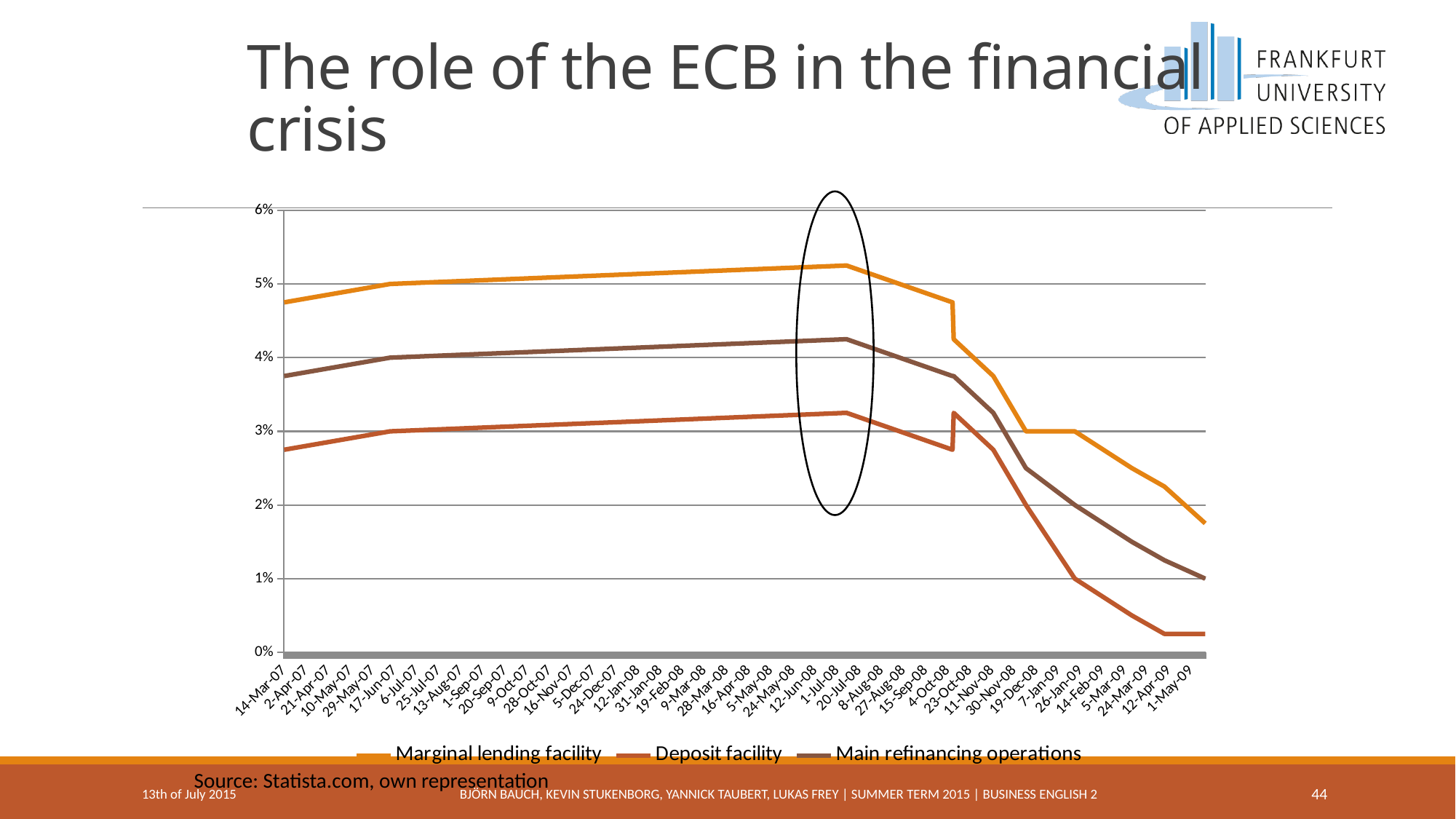
What is the highest value shown on the vertical axis? 6% What is the value of the Marginal lending facility at 17-Jun-07? 5% Is the value of the Marginal lending facility at 14-Mar-07 greater or less than 5%? less Which series has the lowest values throughout the chart? Deposit facility What is the value of Main refinancing operations at 1-May-09? 1% Which series has the highest values throughout the chart? Marginal lending facility At 1-May-09, which is larger: the Marginal lending facility or Main refinancing operations? Marginal lending facility Is the value of the Deposit facility at 1-May-09 greater or less than 1%? less What kind of chart is shown on the slide? line chart How many series does the legend list? 3 Do the values of the Deposit facility rise or fall between 20-Jul-08 and 1-May-09? fall Is the value of Main refinancing operations at 20-Jul-08 greater or less than 4%? greater